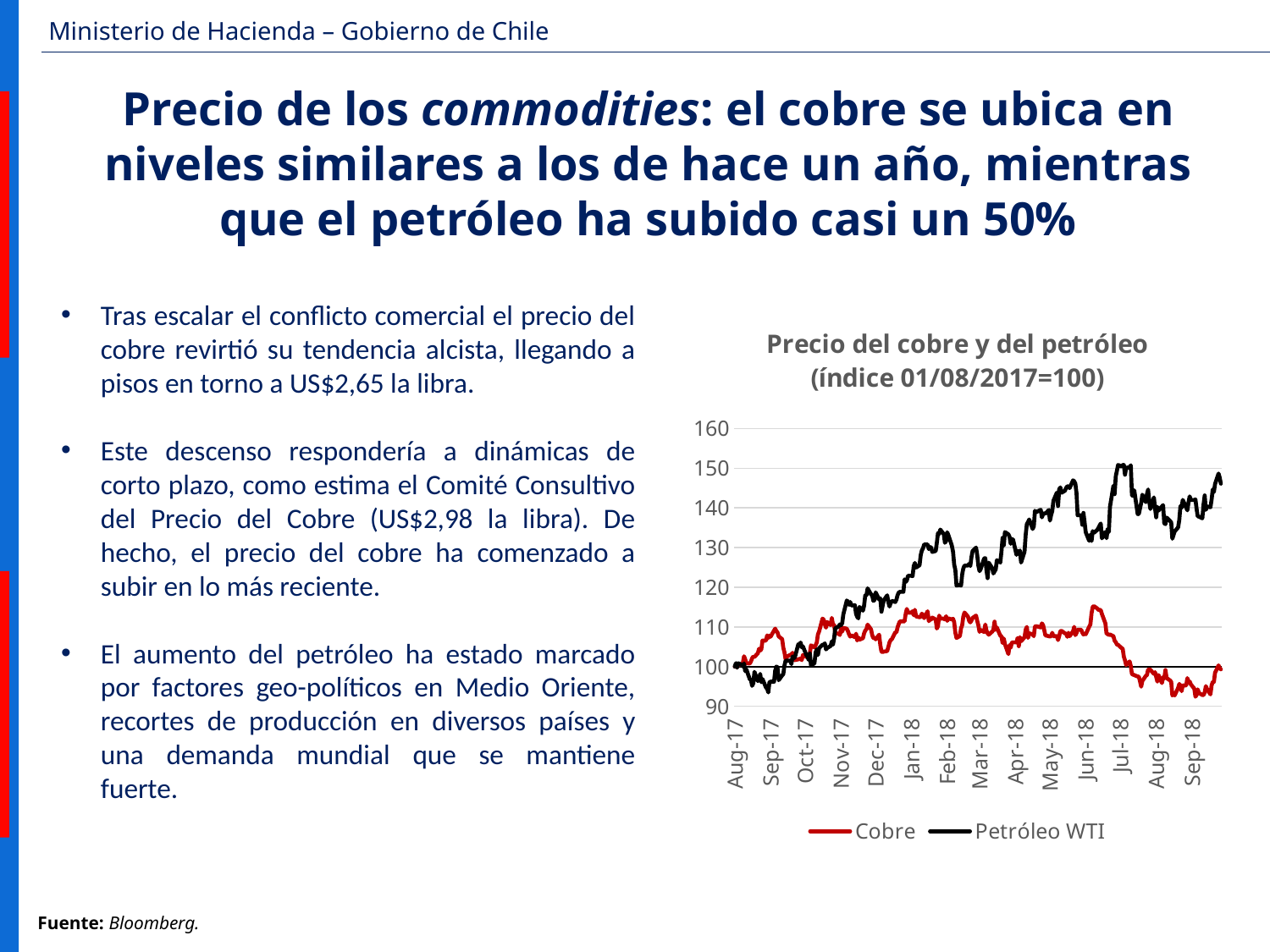
Which series reaches the highest value on the chart? Petróleo WTI Is the value for Cobre in Aug-18 greater or less than 100? less Does the Petróleo WTI line overall rise or fall from Aug-17 to Sep-18? Rise Is the value for Petróleo WTI in Apr-18 greater or less than 120? greater Which colour is used for the Petróleo WTI line? Black What is the title of the chart? Precio del cobre y del petróleo (índice 01/08/2017=100) Is the value for Petróleo WTI in Sep-17 greater or less than 110? less At Sep-18, which series has the higher value, Cobre or Petróleo WTI? Petróleo WTI What kind of chart is shown on the slide? Line chart How many series does the chart legend list? 2 How many month labels are shown on the x axis? 14